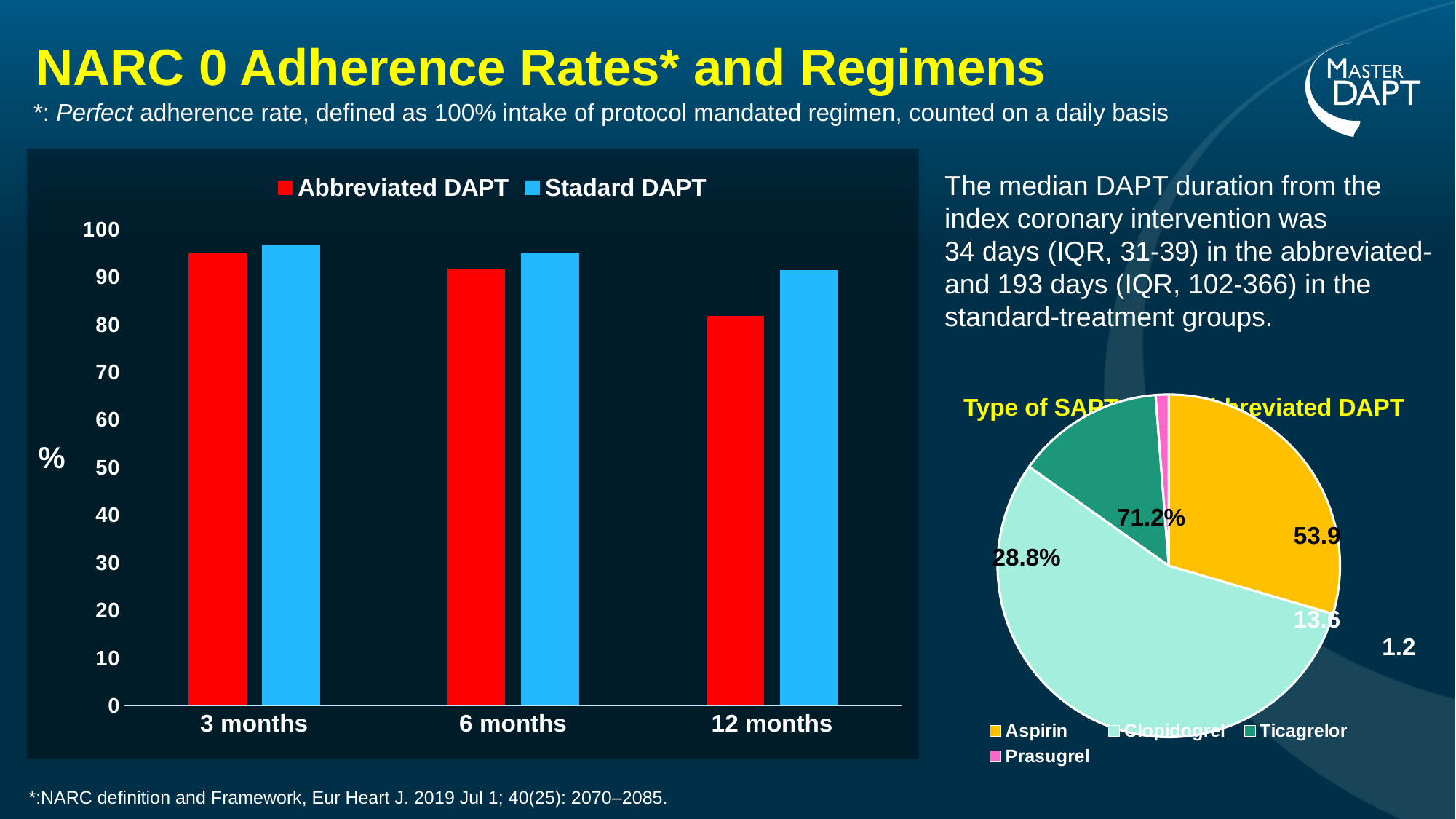
In the bar chart on the left, what label is shown on the y axis? % In the bar chart on the left, at 12 months, which series has the larger value, Abbreviated DAPT or Stadard DAPT? Stadard DAPT In the bar chart on the left, is the Stadard DAPT value at 3 months greater or less than 90? greater In the bar chart on the left, is the Abbreviated DAPT value at 3 months greater or less than 90? greater In the pie chart on the right, how many entries does the legend list? 4 In the bar chart on the left, how many series does the legend list? 2 In the bar chart on the left, is the Abbreviated DAPT value at 12 months greater or less than 90? less In the pie chart on the right, which slice is the smallest? Prasugrel In the bar chart on the left, at which time point is the Abbreviated DAPT adherence rate lowest? 12 months In the bar chart on the left, how many time-point categories are shown on the x axis? 3 What kind of chart is the chart on the left of the slide? bar chart In the bar chart on the left, do the Abbreviated DAPT values rise or fall from 3 months to 12 months? fall